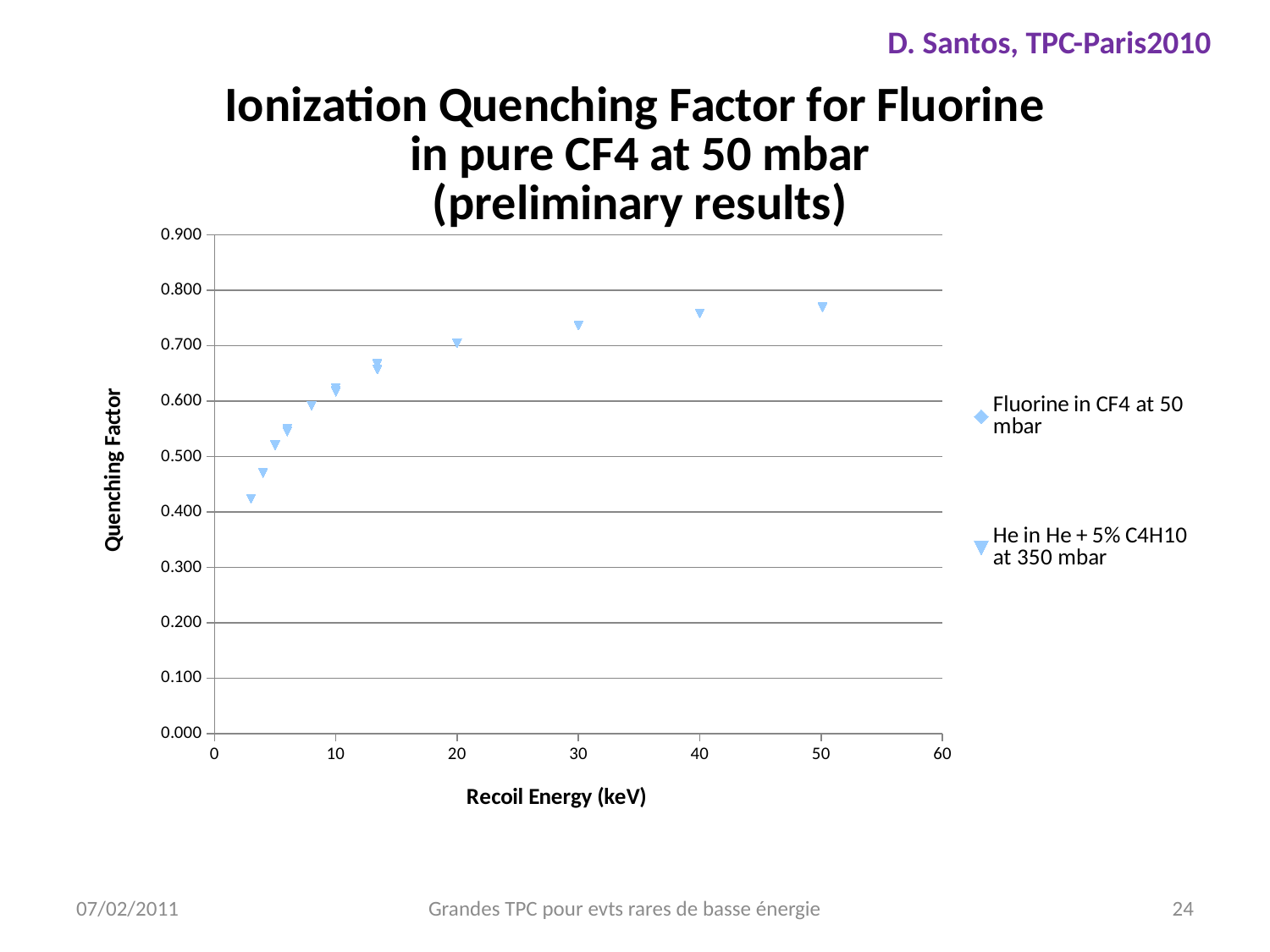
Is the quenching factor plotted at 50 keV greater or less than 0.700? greater Is the quenching factor plotted at 40 keV greater or less than 0.800? less How many series does the chart legend list? 2 At which recoil energy on the x axis is the highest quenching factor plotted? 50 keV Is the quenching factor plotted at 30 keV greater or less than 0.700? greater What is the label of the x axis? Recoil Energy (keV) What kind of chart is shown on the slide? scatter chart What is the label of the y axis? Quenching Factor Do the plotted quenching factor values rise or fall as recoil energy increases along the x axis? rise